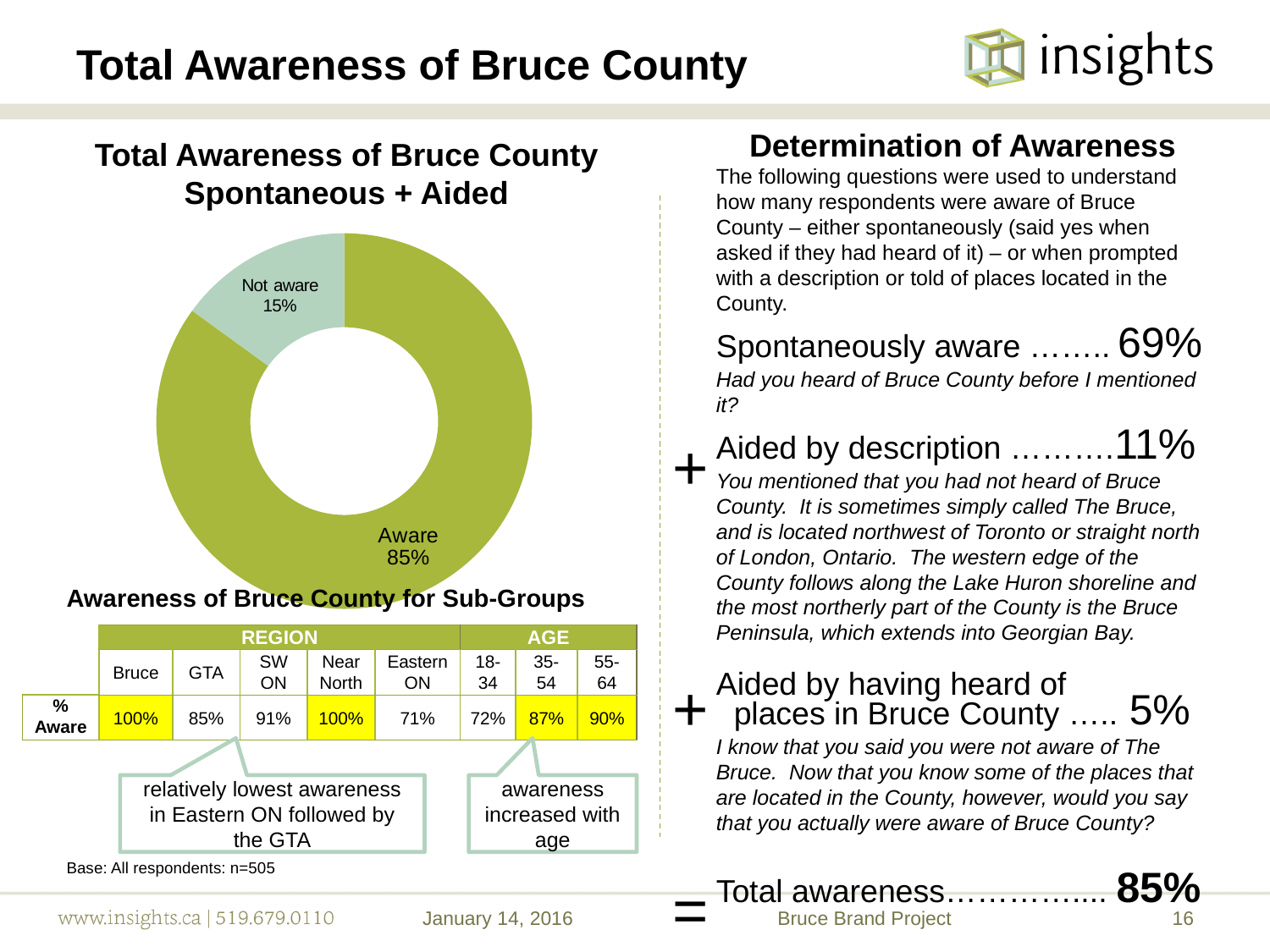
What colour is the Aware slice in the donut chart? Green Which slice of the donut chart is the smallest? Not aware What share of the donut chart does the Aware slice represent? 85% In the donut chart, which is larger: Aware or Not aware? Aware By how many percentage points does the Aware slice exceed the Not aware slice in the donut chart? 70 percentage points Which slice of the donut chart is the largest? Aware In the donut chart, what percentage of respondents are not aware of Bruce County? 15% What do the two slices of the donut chart add up to? 100% What is the title of the donut chart? Total Awareness of Bruce County Spontaneous + Aided How many slices does the donut chart have? 2 In the donut chart, what percentage of respondents are aware of Bruce County? 85% What type of chart is used to show total awareness of Bruce County? Donut (pie) chart